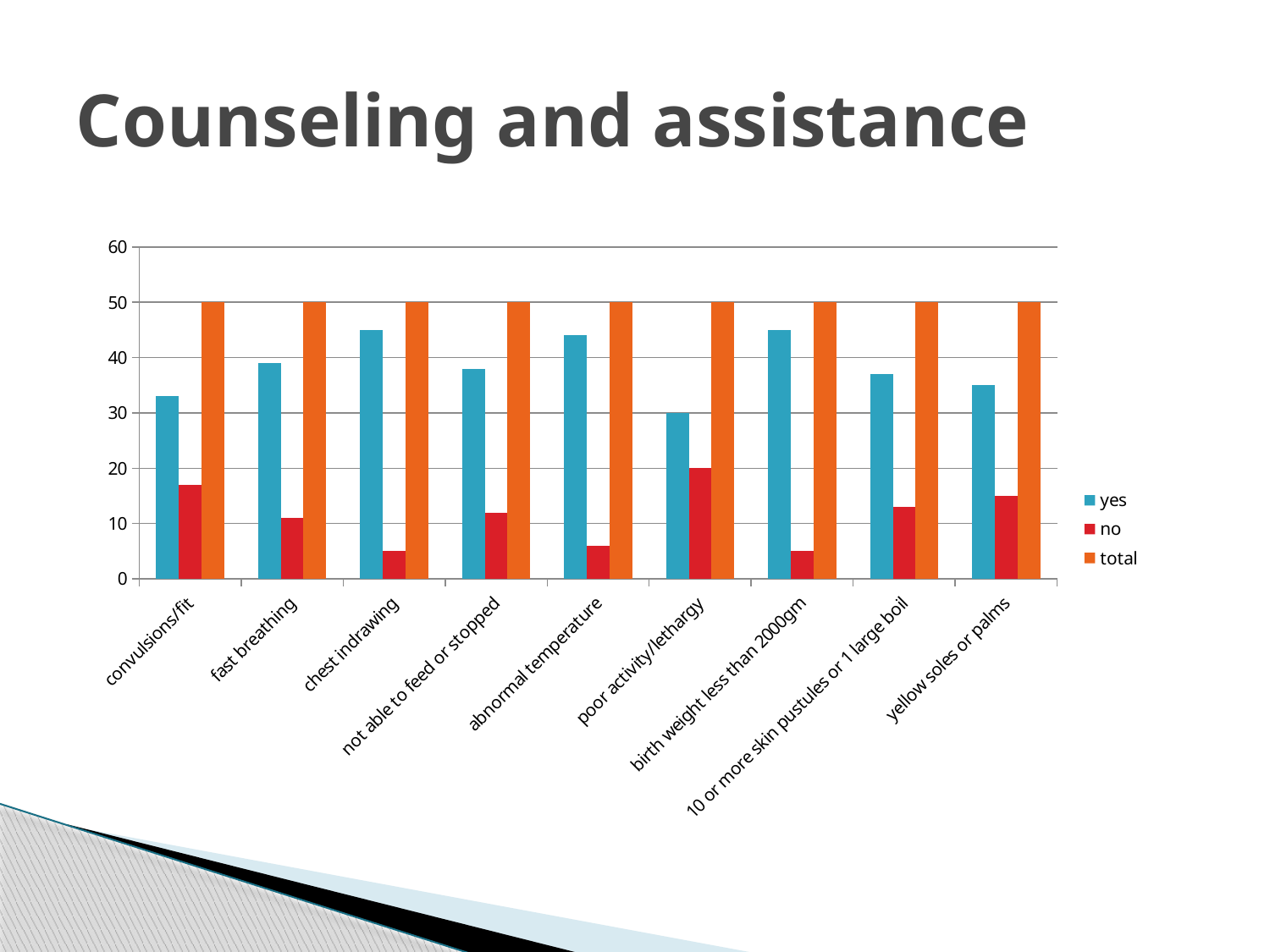
How many series does the legend list? 3 How many categories are shown along the x axis? 9 What is the value of the total bar for convulsions/fit? 50 Is the yes value for birth weight less than 2000gm greater or less than 40? greater Is the yes value for chest indrawing greater or less than 40? greater Is the no value for chest indrawing greater or less than 10? less What is the title of the slide containing the chart? Counseling and assistance What kind of chart is shown on the slide? bar chart Which category has the lowest yes value? poor activity/lethargy Which is larger, the yes value for fast breathing or the yes value for chest indrawing? chest indrawing Which category has the highest no value? poor activity/lethargy What is the value of the no bar for poor activity/lethargy? 20